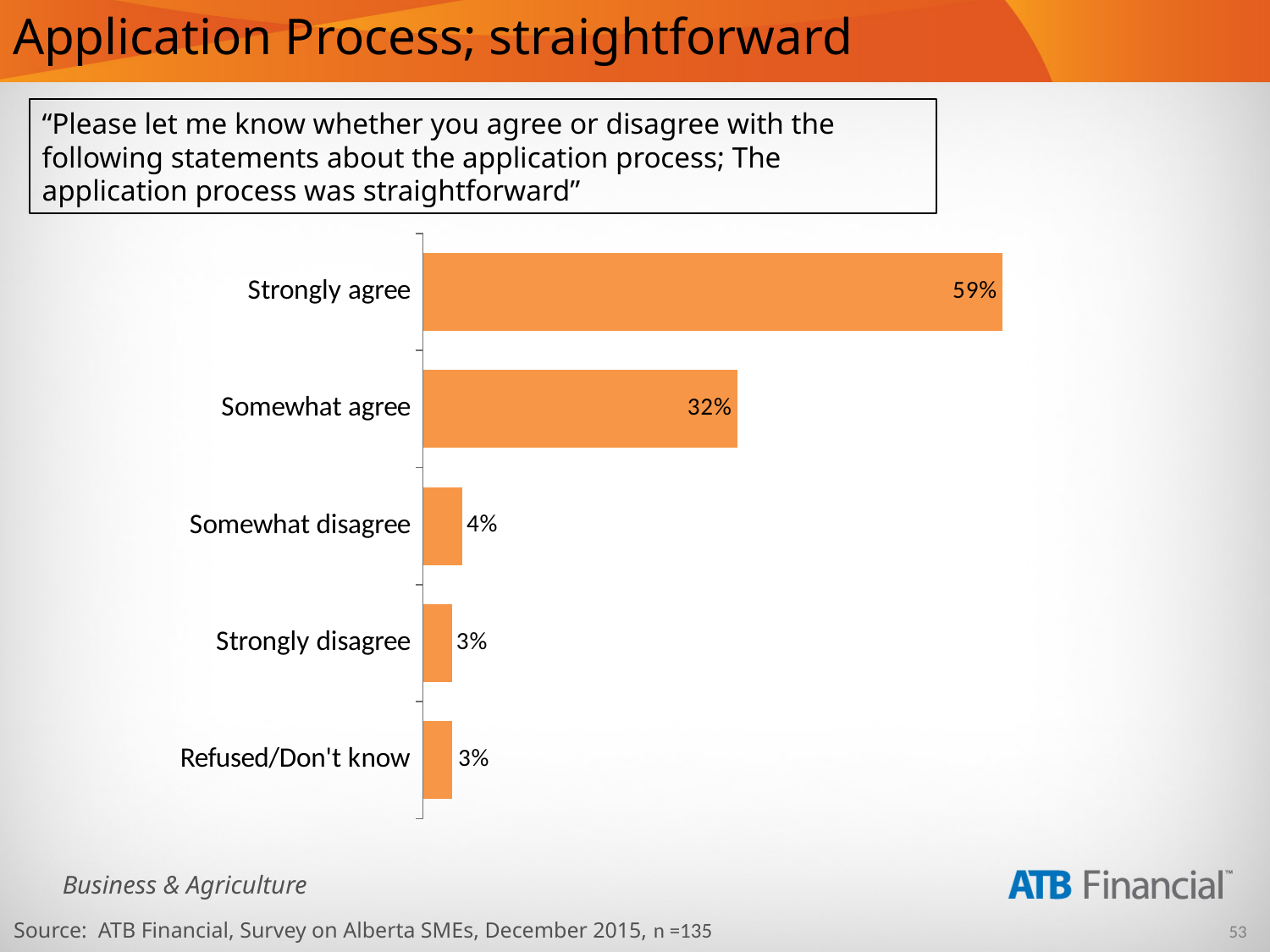
What is the value for Somewhat agree? 32% What is the combined value of Strongly agree and Somewhat agree? 91% What is the value for Refused/Don't know? 3% What is the difference between the Strongly agree and Somewhat agree values? 27 percentage points What colour are the bars in the chart? Orange What is the sample size (n) stated in the source line? 135 How many categories are shown in the chart? 5 What is the value for Somewhat disagree? 4% Which category has the highest value? Strongly agree What kind of chart is shown on the slide? Bar chart What percentage of respondents strongly agree that the application process was straightforward? 59% Which is larger, the value for Somewhat disagree or the value for Strongly disagree? Somewhat disagree